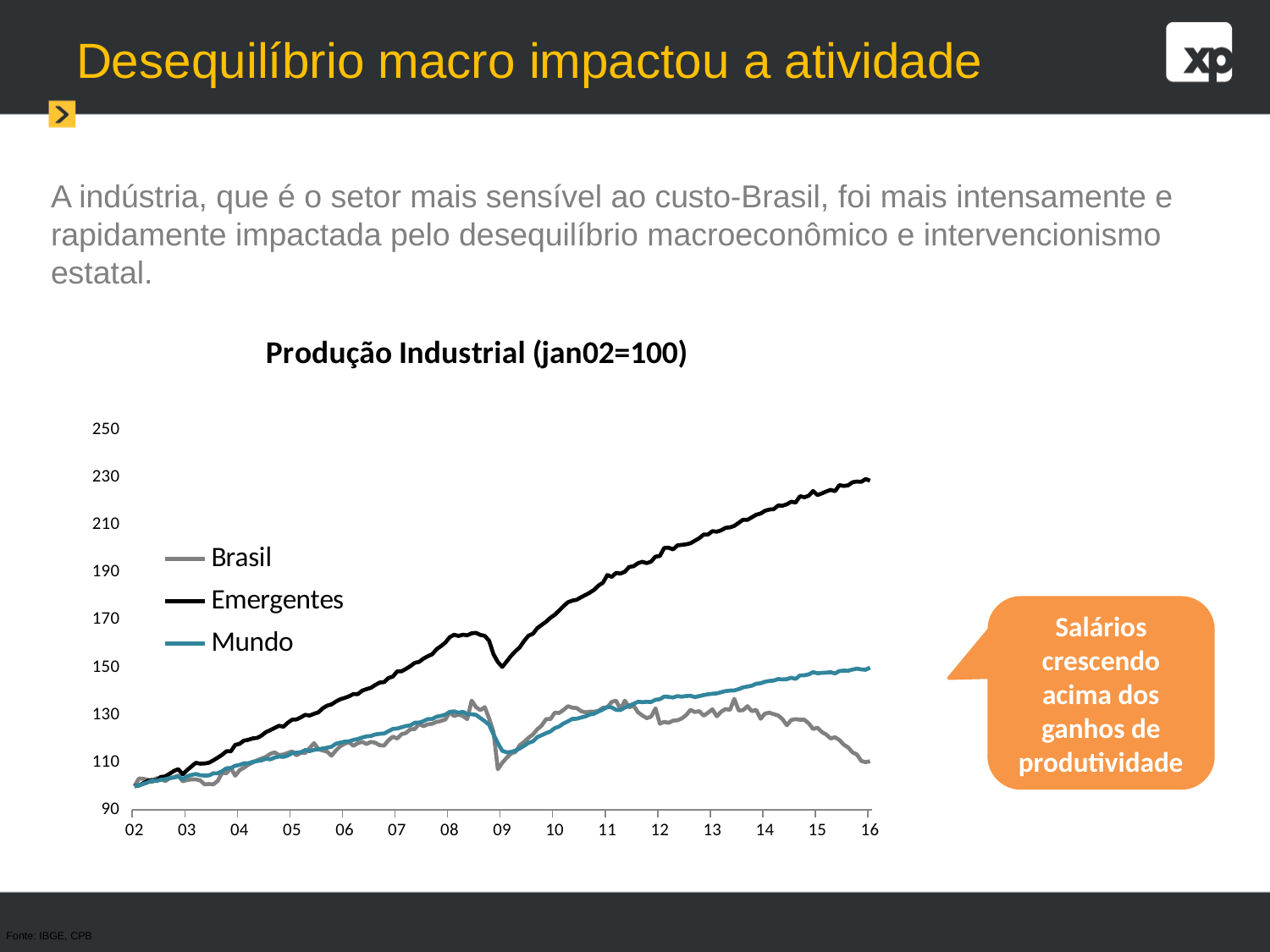
Is the value for Emergentes at 16 greater or less than 210? greater What kind of chart is shown on the slide? line chart How many year labels are shown on the x axis of the chart? 15 How many series does the legend of the chart list? 3 Is the value for Mundo at 16 greater or less than 130? greater Is the value for Brasil at 16 greater or less than 130? less Does the Emergentes series generally rise or fall from 02 to 16? rise At 16, which is larger: the value for Emergentes or the value for Mundo? Emergentes Which series has the highest value at the end of the chart (16)? Emergentes Which series has the lowest value at the end of the chart (16)? Brasil Which series are listed in the chart's legend? Brasil, Emergentes, Mundo What is the title of the chart? Produção Industrial (jan02=100)